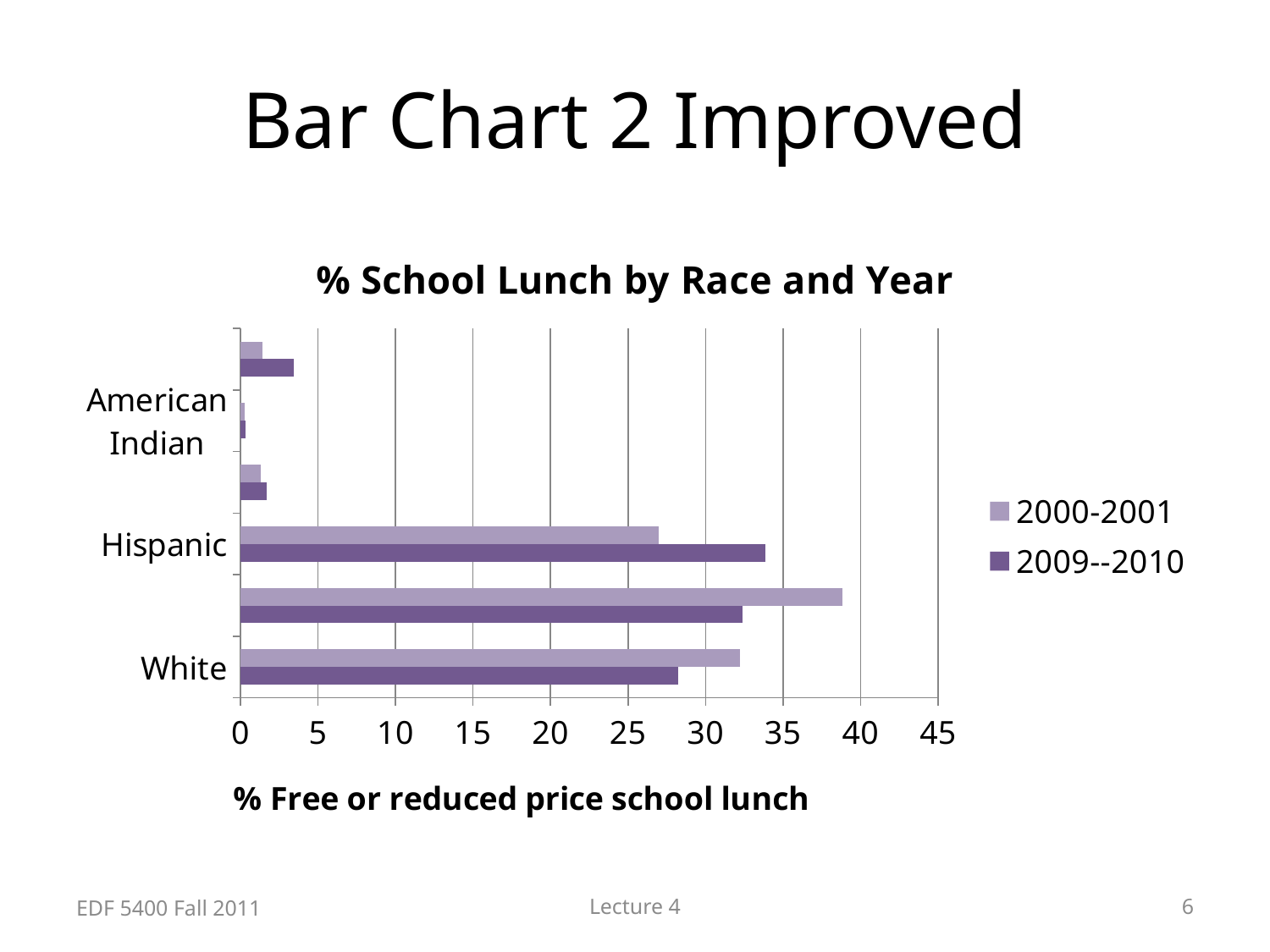
For Hispanic, which series has the larger value, 2000-2001 or 2009--2010? 2009--2010 Among the labeled categories White, Hispanic and American Indian, which has the lowest 2009--2010 value? American Indian Is the 2000-2001 value for White greater or less than 30? greater Is the 2009--2010 value for American Indian greater or less than 5? less What is the label on the horizontal axis of the chart? % Free or reduced price school lunch Is the 2009--2010 value for Hispanic greater or less than 30? greater What is the title of the chart? % School Lunch by Race and Year What kind of chart is shown on the slide? bar chart For White, which series has the larger value, 2000-2001 or 2009--2010? 2000-2001 How many series does the legend list? 2